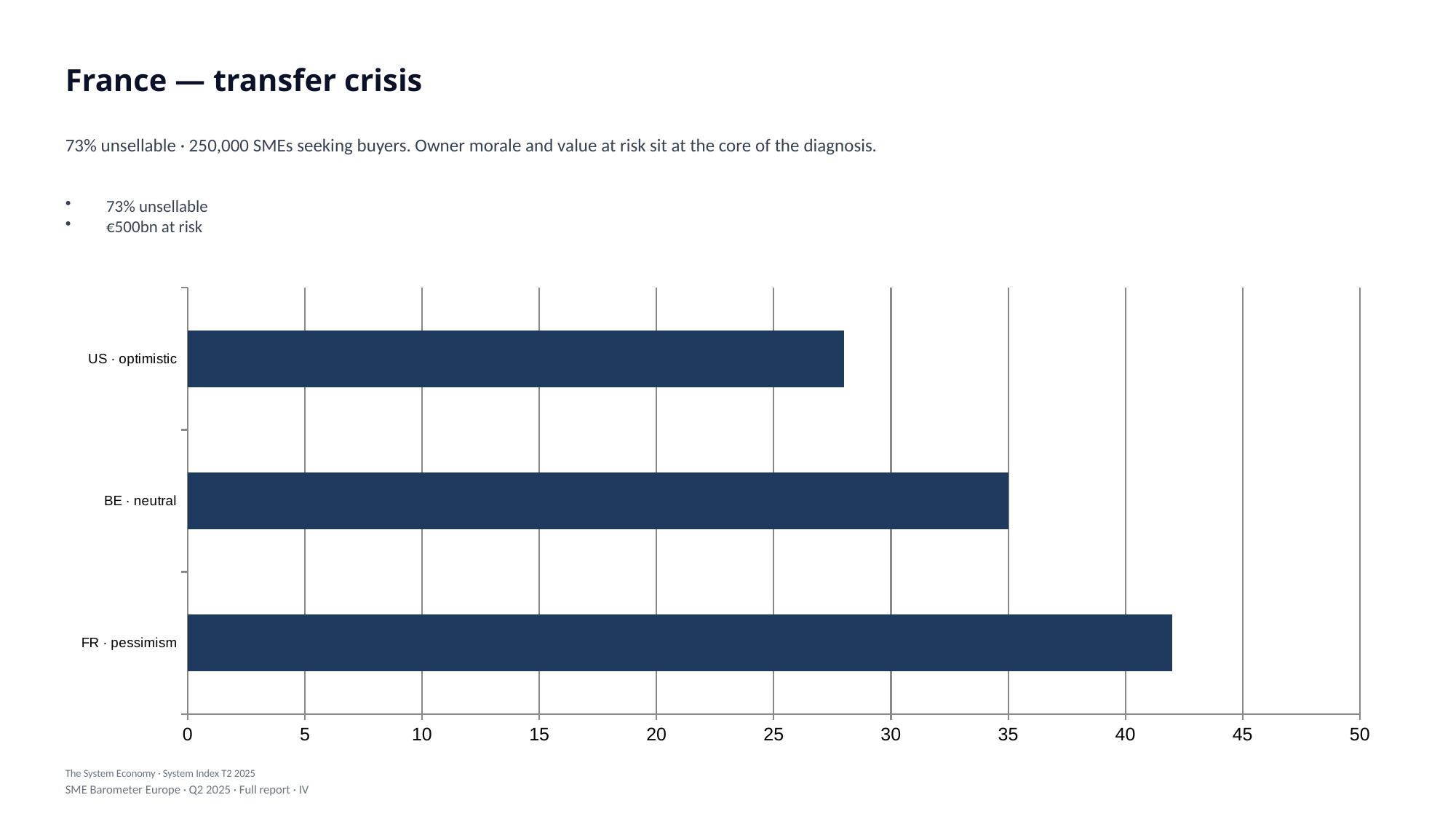
Is the value for FR · pessimism greater or less than 45? less How many categories are plotted in the bar chart? 3 Is the value for FR · pessimism greater or less than 40? greater What kind of chart is shown on the slide? bar chart Is the value for US · optimistic greater or less than 30? less Which category has the longest bar? FR · pessimism What is the title of the slide containing the chart? France — transfer crisis Which is larger, the value for BE · neutral or the value for US · optimistic? BE · neutral What is the value for BE · neutral? 35 What is the maximum value shown on the horizontal axis? 50 Which category has the shortest bar? US · optimistic